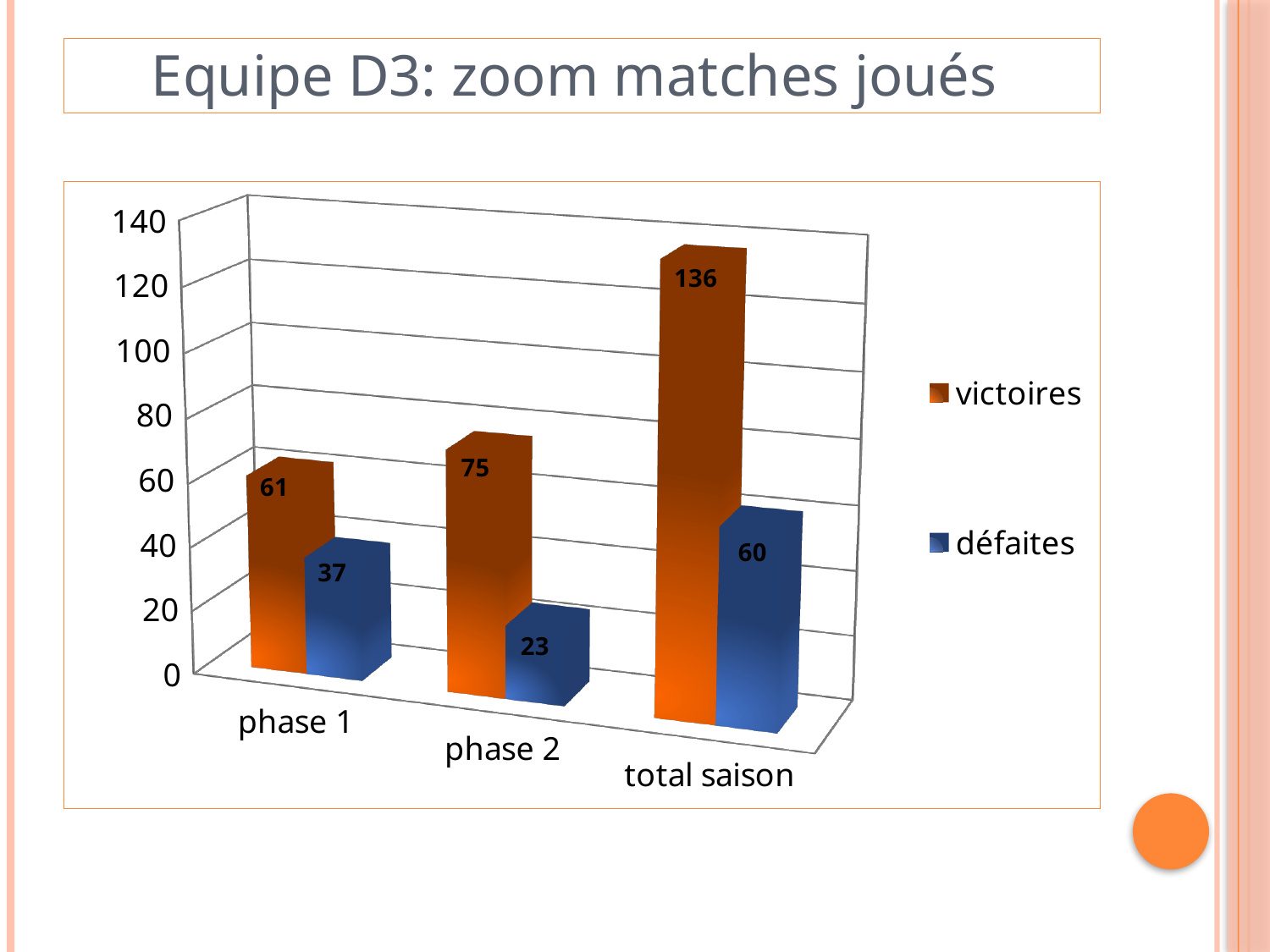
Which category has the highest value for victoires? total saison What is the difference between victoires and défaites for phase 2? 52 How many categories are shown on the x axis? 3 What is the value of défaites for total saison? 60 Which is larger: défaites for phase 1 or défaites for phase 2? défaites for phase 1 What is the value of victoires for total saison? 136 How many series does the legend list? 2 What is the title of the slide containing the chart? Equipe D3: zoom matches joués Which category has the lowest value for défaites? phase 2 What kind of chart is shown on the slide? bar chart What is the value of victoires for phase 1? 61 What is the value of défaites for phase 2? 23